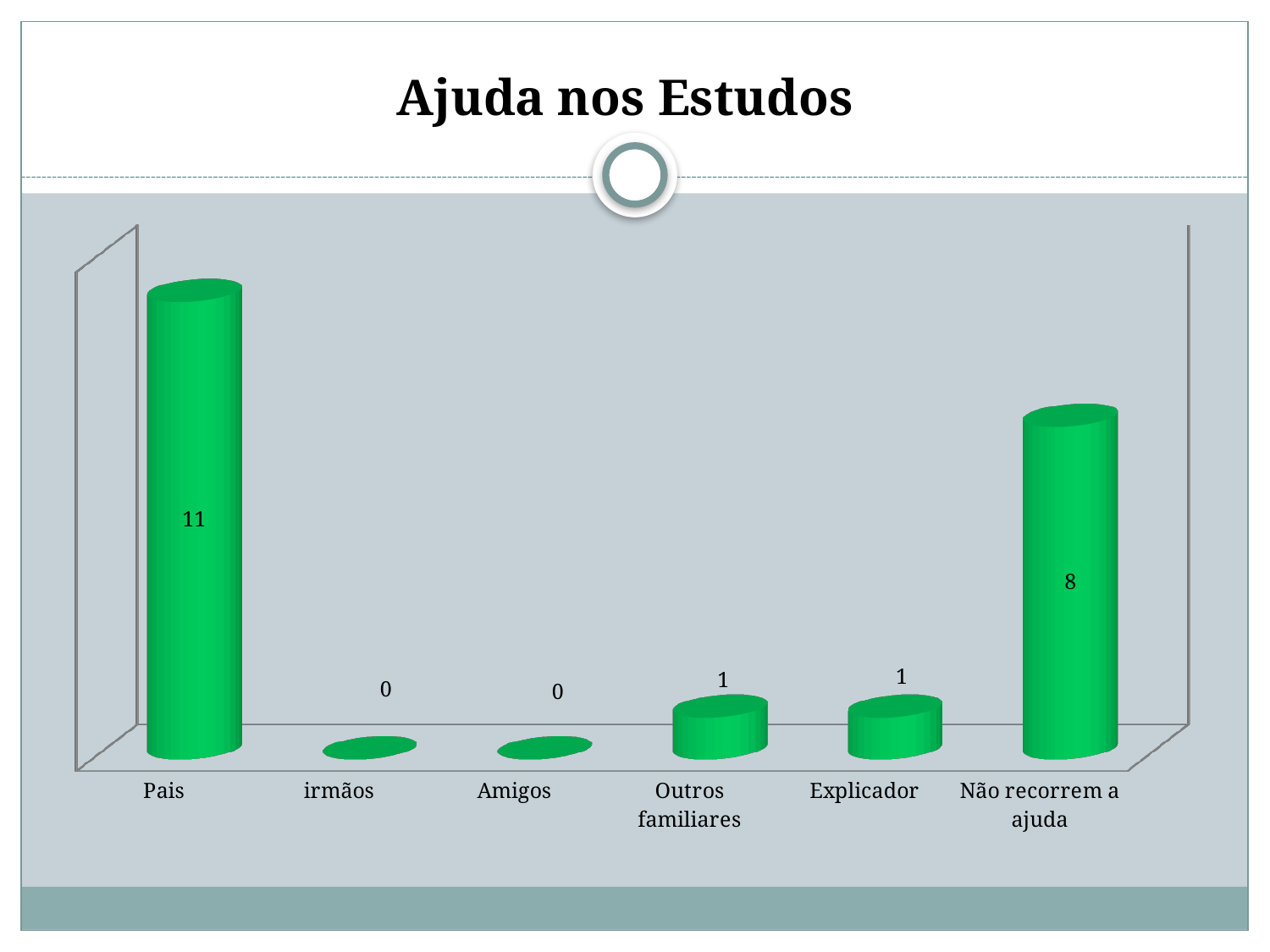
What is the value for Não recorrem a ajuda? 8 What is the value for Pais? 11 What is the value for Explicador? 1 What is the value for irmãos? 0 What is the difference between the values for Pais and Não recorrem a ajuda? 3 How many categories have a value of 0? 2 What is the title of the slide? Ajuda nos Estudos Which is larger, the value for Outros familiares or the value for Amigos? Outros familiares Which category has the highest value? Pais What kind of chart is shown on the slide? bar chart How many categories are shown on the x axis? 6 What is the total of the values for Outros familiares and Explicador? 2